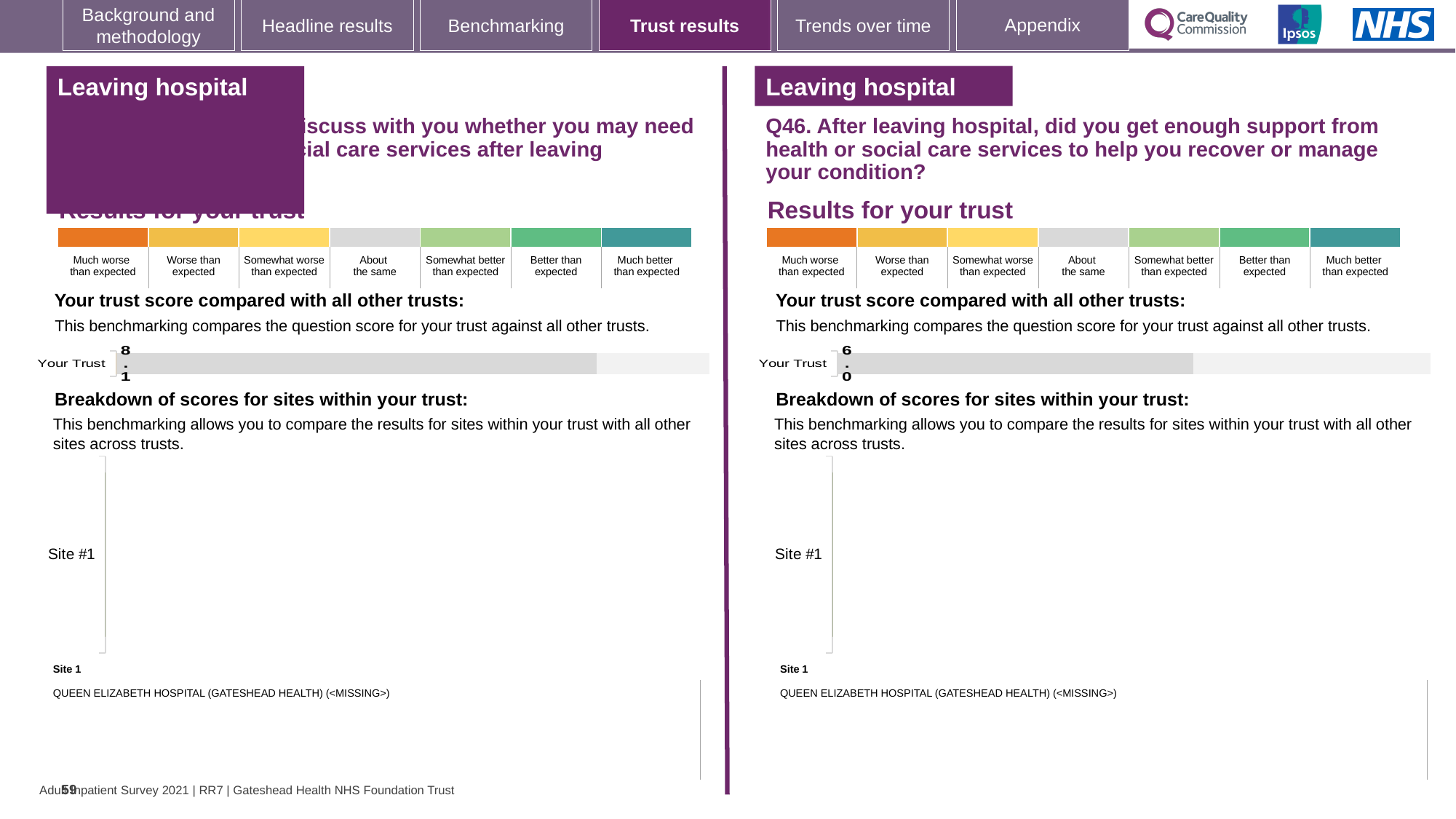
How many bars are plotted in the left panel's 'Your trust score compared with all other trusts' chart? 1 What is the difference between the left panel's Your Trust score and the right panel's (Q46) Your Trust score? 2.1 On the right panel (Q46) 'Your trust score compared with all other trusts' chart, what is the score shown for Your Trust? 6.0 Which panel's Your Trust score is larger: the left panel's or the right panel's (Q46)? The left panel's How many rating categories does the colour scale above the right panel's (Q46) 'Results for your trust' chart show? 7 How many sites are listed in the right panel's (Q46) 'Breakdown of scores for sites within your trust' chart? 1 On the left panel's 'Your trust score compared with all other trusts' chart, what is the score shown for Your Trust? 8.1 What kind of chart is used for 'Your trust score compared with all other trusts' on the right panel (Q46)? Bar chart What is the label of the single category in the right panel's (Q46) trust score chart? Your Trust Which site is named as Site 1 in the left panel's site breakdown? QUEEN ELIZABETH HOSPITAL (GATESHEAD HEALTH) (<MISSING>)